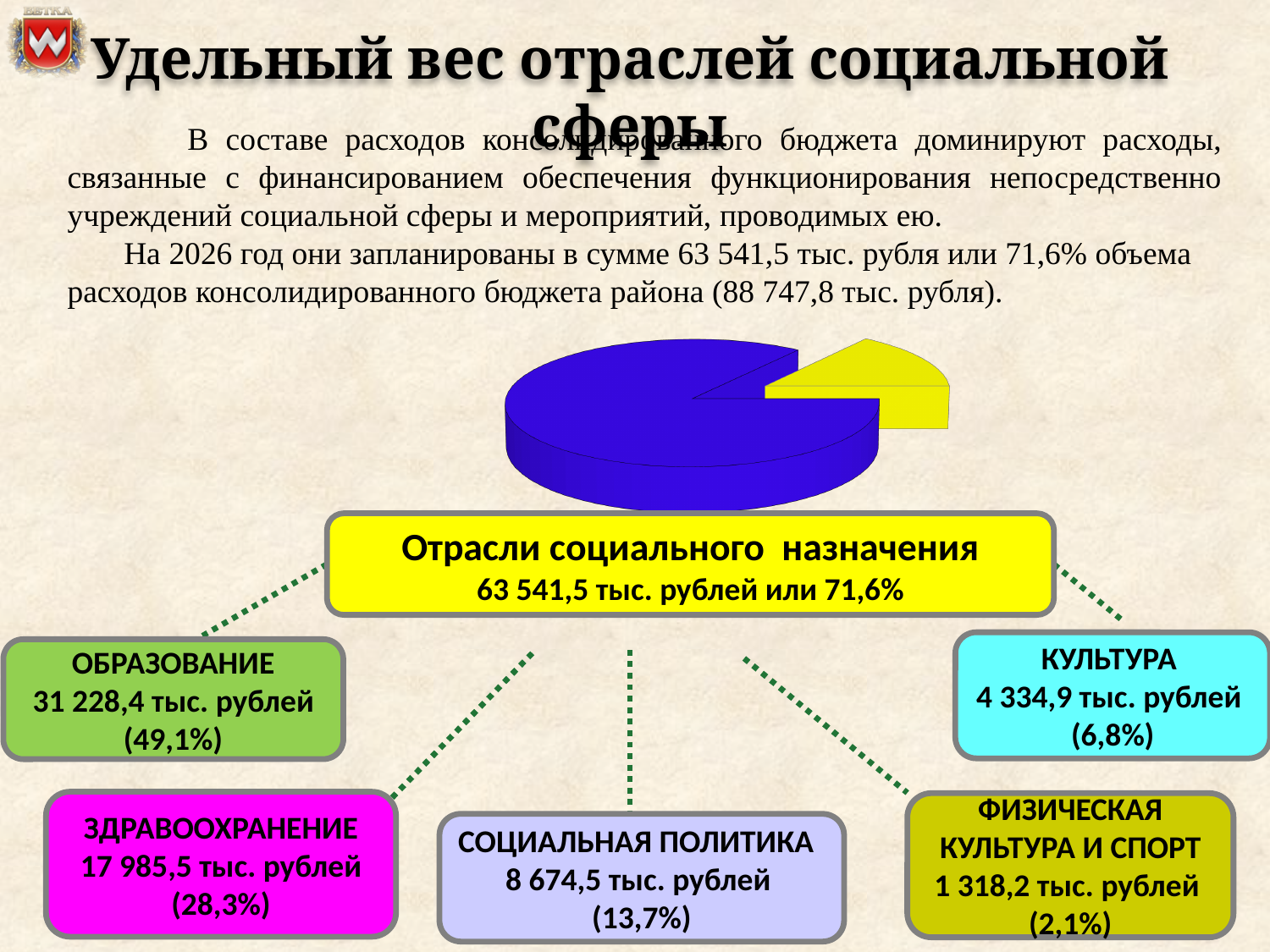
Which slice of the pie chart is pulled out (exploded) from the rest of the pie? the yellow slice Which slice of the pie chart is the smallest? the yellow slice What kind of chart is shown on the slide? pie chart What two colours are used for the slices of the pie chart? blue and yellow Which slice of the pie chart is larger, the blue one or the yellow one? the blue one Does the yellow slice of the pie chart take up more or less than half of the pie? less How many slices does the pie chart have? 2 Does the blue slice of the pie chart take up more or less than half of the pie? more